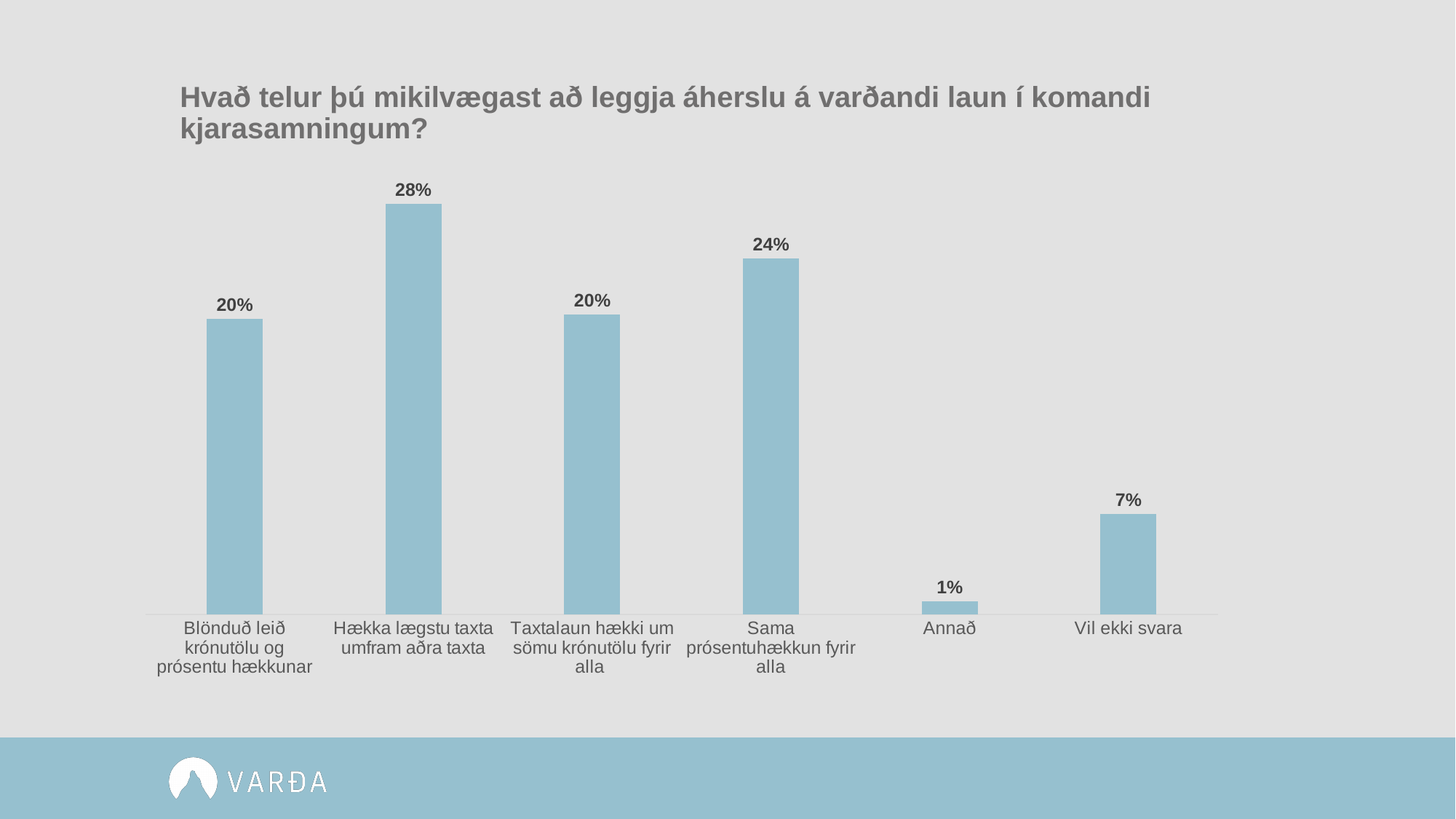
What is the difference between "Hækka lægstu taxta umfram aðra taxta" and "Sama prósentuhækkun fyrir alla"? 4% What is the title of the chart? Hvað telur þú mikilvægast að leggja áherslu á varðandi laun í komandi kjarasamningum? What is the value for "Vil ekki svara"? 7% What is the value for "Sama prósentuhækkun fyrir alla"? 24% How many categories are shown in the chart? 6 What kind of chart is shown on the slide? Bar chart Which category has the lowest value? Annað Which is larger: "Sama prósentuhækkun fyrir alla" or "Taxtalaun hækki um sömu krónutölu fyrir alla"? Sama prósentuhækkun fyrir alla Which category has the highest value? Hækka lægstu taxta umfram aðra taxta What is the value for "Annað"? 1% What is the difference between "Vil ekki svara" and "Annað"? 6% What is the value for "Hækka lægstu taxta umfram aðra taxta"? 28%